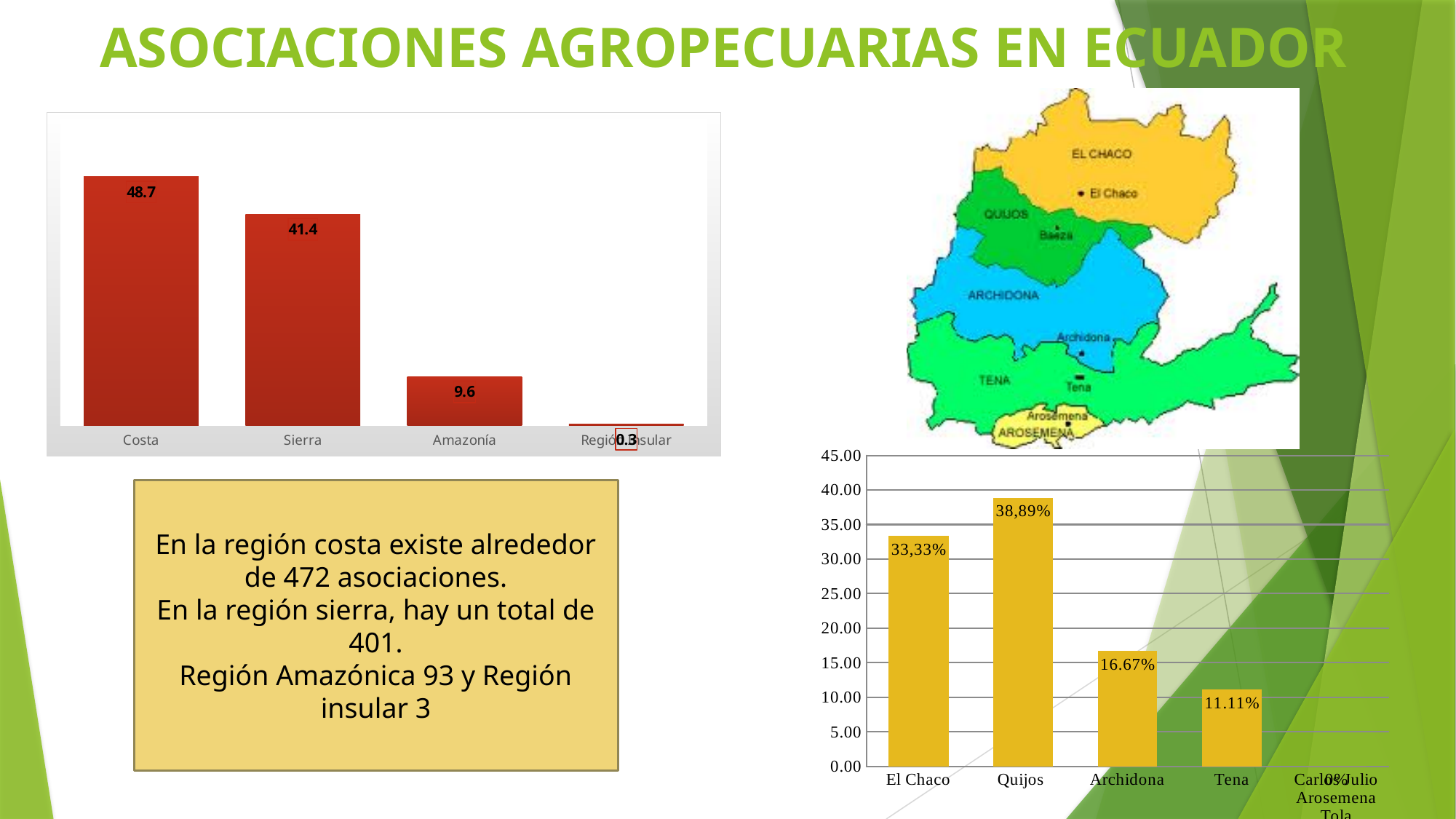
In the left bar chart, what is the difference between the values for Costa and Sierra? 7.3 In the right bar chart, which canton has the highest value? Quijos In the left bar chart, what is the value for Costa? 48.7 In the left bar chart, which region has the highest value? Costa In the right bar chart, what is the value for Quijos? 38,89% In the right bar chart, which is larger, the value for El Chaco or the value for Archidona? El Chaco In the left bar chart, how many regions are shown? 4 In the left bar chart, which region has the lowest value? Región Insular In the right bar chart, what is the value for Tena? 11.11% In the left bar chart, what is the value for Amazonía? 9.6 In the right bar chart, is the value for Archidona greater or less than 20.00? less What kind of chart is the chart on the right of the slide? bar chart